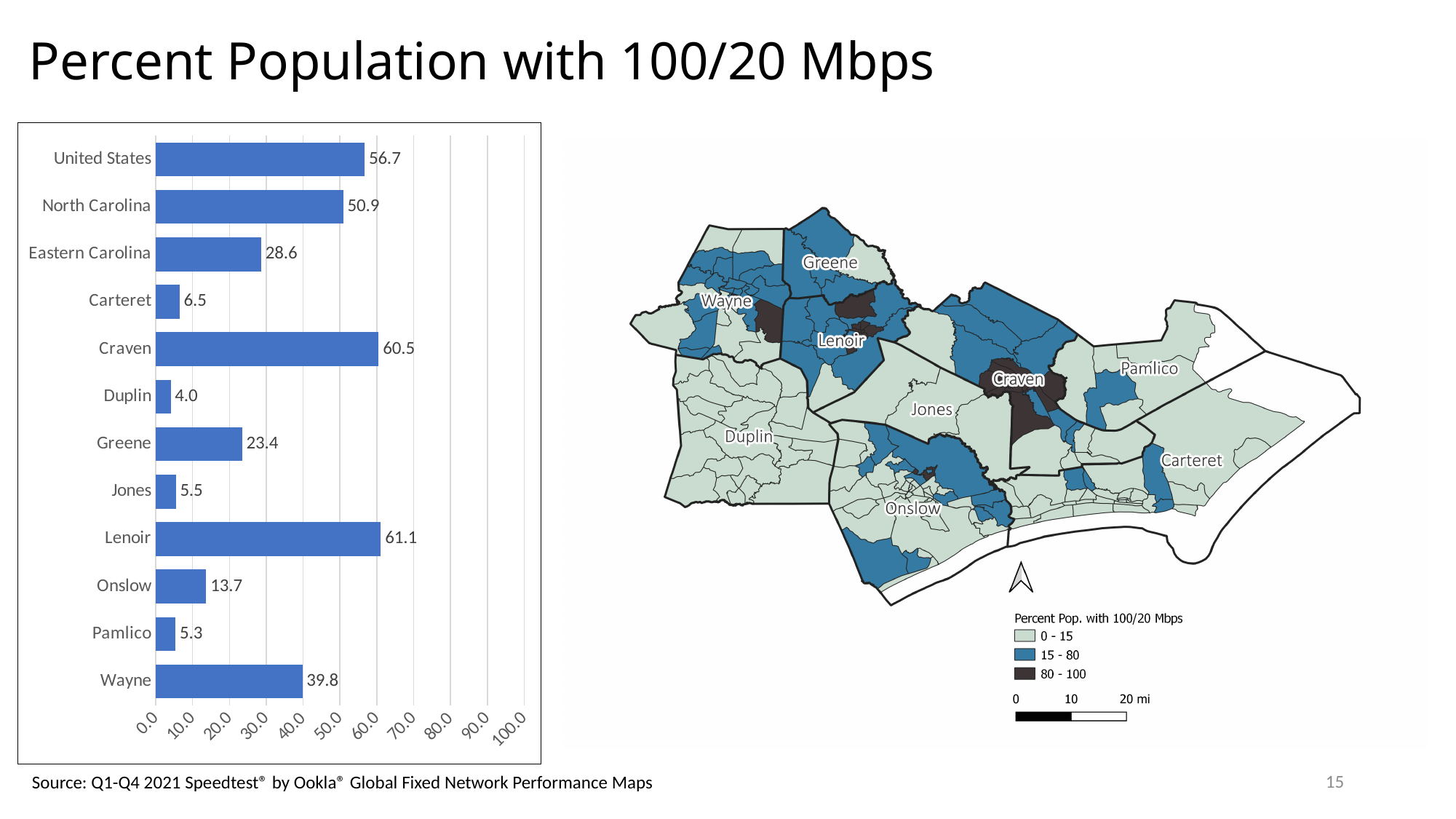
Which is larger in the bar chart, Craven or Wayne? Craven What is the difference between the United States value and the Eastern Carolina value in the bar chart? 28.1 What is the value for Wayne in the bar chart? 39.8 Is the value for Onslow in the bar chart greater or less than 20.0? less How many categories are shown in the bar chart? 12 What is the difference between the Greene value and the Jones value in the bar chart? 17.9 What is the value for North Carolina in the bar chart? 50.9 What is the value for Lenoir in the bar chart? 61.1 Which category has the highest value in the bar chart? Lenoir What is the title of the slide? Percent Population with 100/20 Mbps What kind of chart is shown on the left of the slide? Bar chart Which category has the lowest value in the bar chart? Duplin